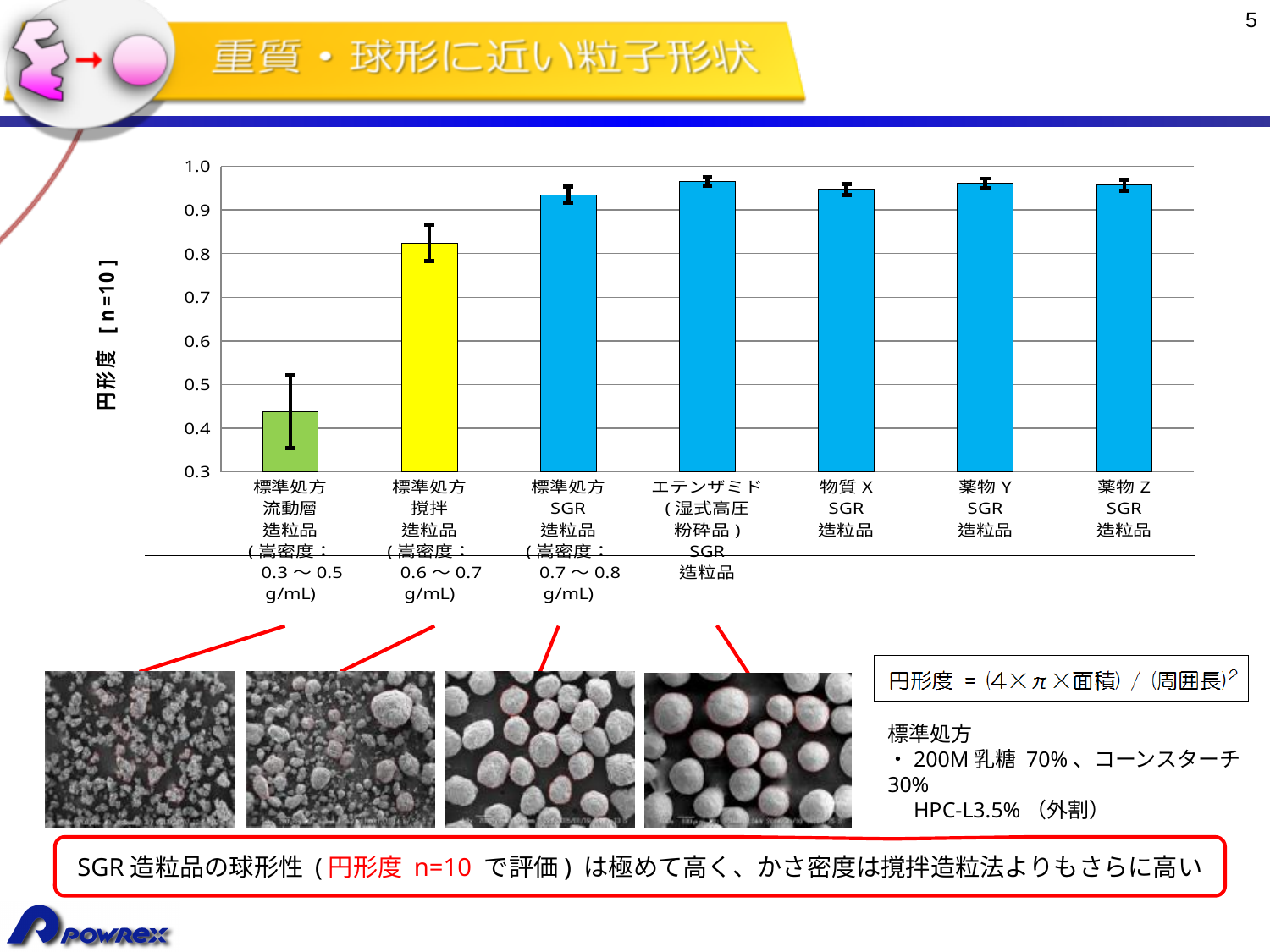
What is the label of the vertical axis of the chart? 円形度 [n=10] Is the 円形度 value for 標準処方 撹拌 造粒品 greater or less than 0.7? greater How many bars (categories) are plotted in the chart? 7 Which has a higher 円形度 value: 標準処方 撹拌 造粒品 or 標準処方 SGR 造粒品? 標準処方 SGR 造粒品 Is the 円形度 value for エテンザミド SGR 造粒品 greater or less than 0.9? greater Is the 円形度 value for 標準処方 流動層 造粒品 greater or less than 0.5? less Which category has the lowest 円形度 value in the chart? 標準処方 流動層 造粒品 What kind of chart is shown on the slide? bar chart Which has a higher 円形度 value: 標準処方 流動層 造粒品 or 標準処方 撹拌 造粒品? 標準処方 撹拌 造粒品 What colour is the bar for 標準処方 撹拌 造粒品? yellow